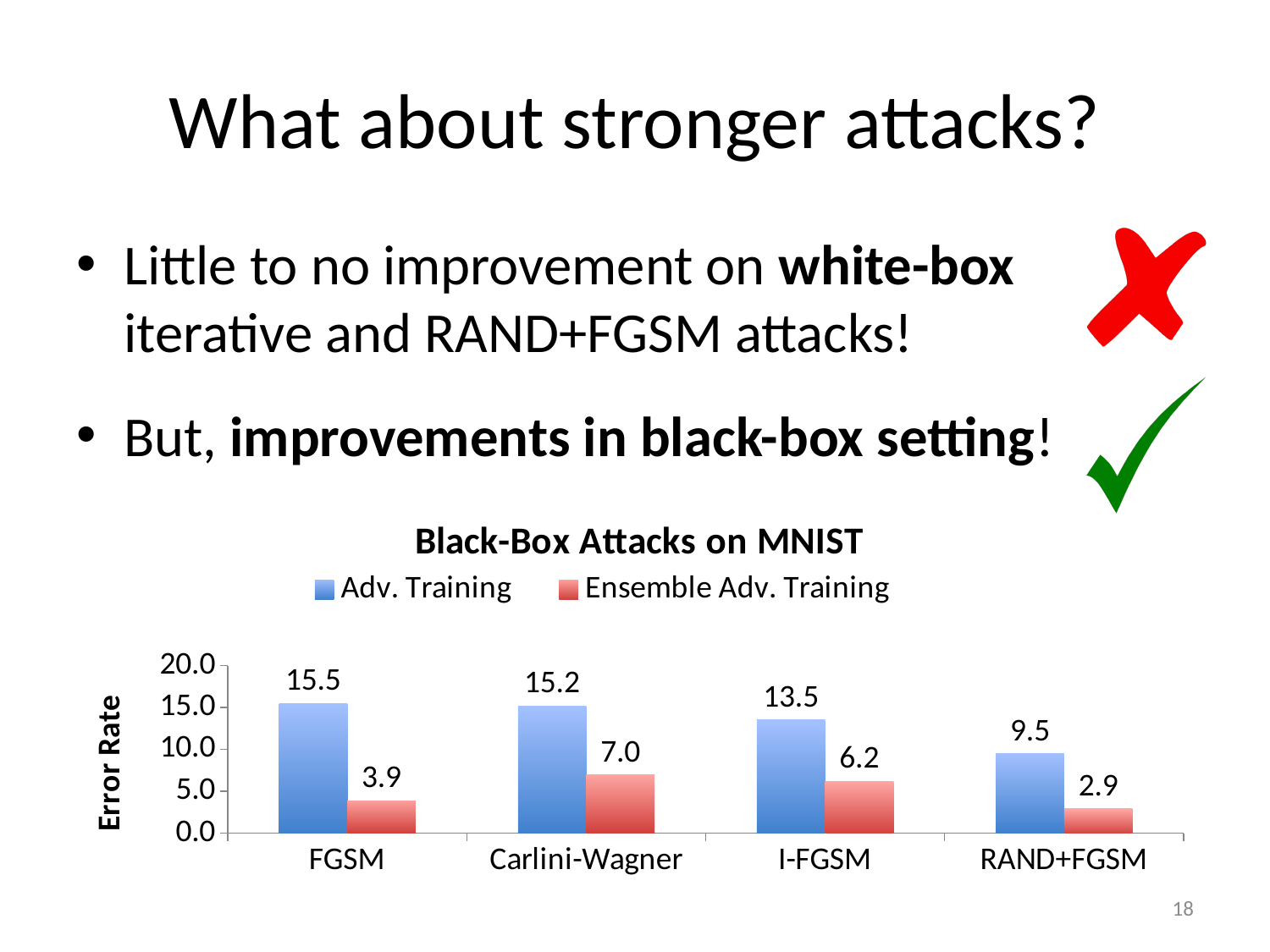
How many series does the legend list? 2 What kind of chart is shown on the slide? bar chart What is the error rate for Ensemble Adv. Training under the Carlini-Wagner attack? 7.0 Is the Adv. Training error rate for RAND+FGSM greater or less than 10.0? less Which attack has the highest error rate for Adv. Training? FGSM What is the difference between the Adv. Training and Ensemble Adv. Training error rates for I-FGSM? 7.3 How many attack categories are shown on the x axis? 4 Which is larger: the Ensemble Adv. Training error rate for Carlini-Wagner or for I-FGSM? Carlini-Wagner What is the error rate for Ensemble Adv. Training under the RAND+FGSM attack? 2.9 What is the error rate for Adv. Training under the FGSM attack? 15.5 Which attack has the lowest error rate for Ensemble Adv. Training? RAND+FGSM What is the title of the chart? Black-Box Attacks on MNIST